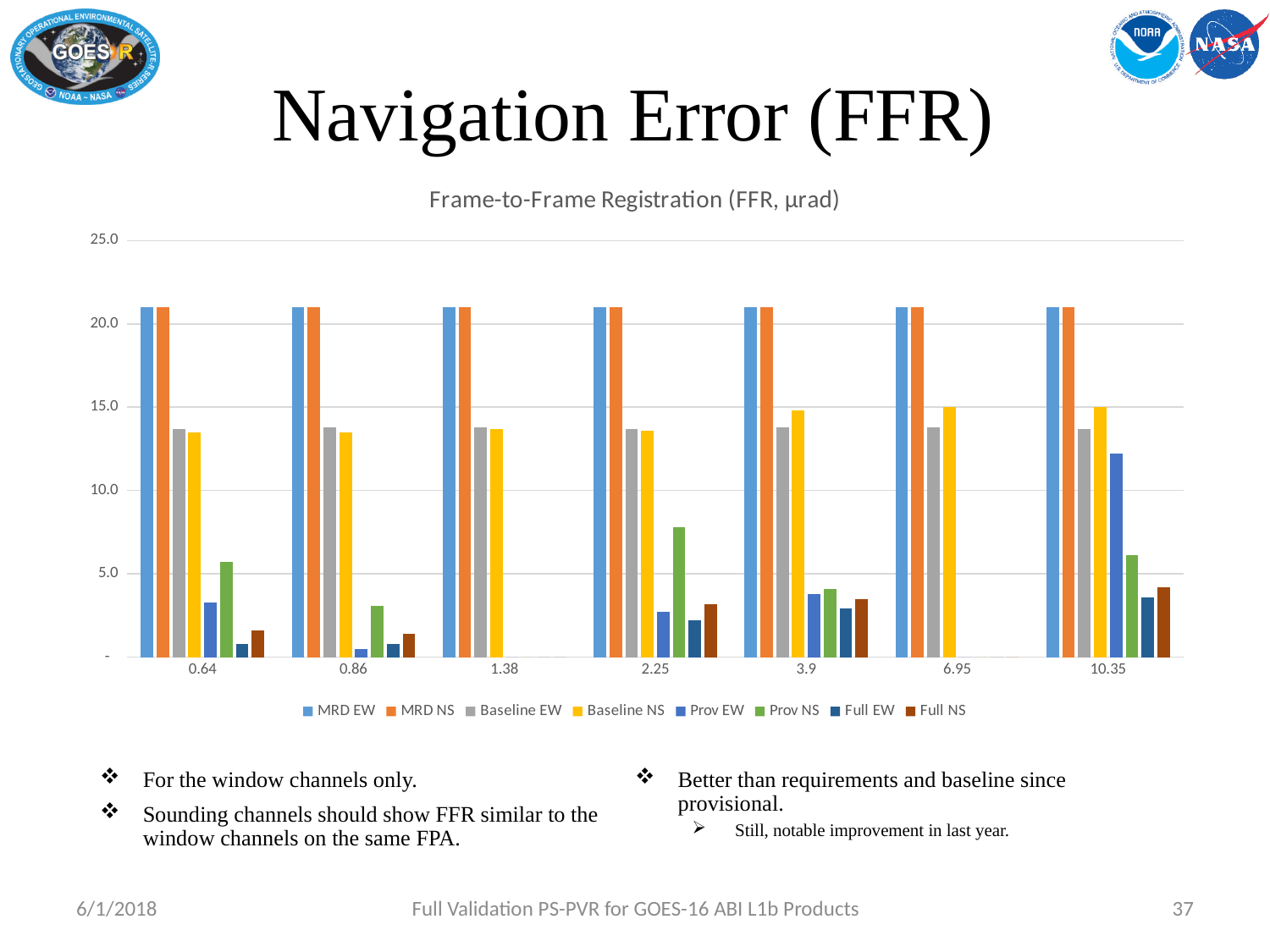
How many series does the chart legend list? 8 Is the value for MRD EW at category 0.64 greater or less than 15.0? greater Is the value for Prov NS at category 2.25 greater or less than 5.0? greater Is the value for Full NS at category 0.64 greater or less than 5.0? less How many categories are shown along the x axis of the chart? 7 Which is larger: the Prov NS value at category 2.25 or the Prov NS value at category 0.86? 2.25 For the Prov EW series, which category has the highest value? 10.35 What is the title of the chart? Frame-to-Frame Registration (FFR, μrad) What kind of chart is shown on the slide? bar chart Which series is listed first in the chart legend? MRD EW